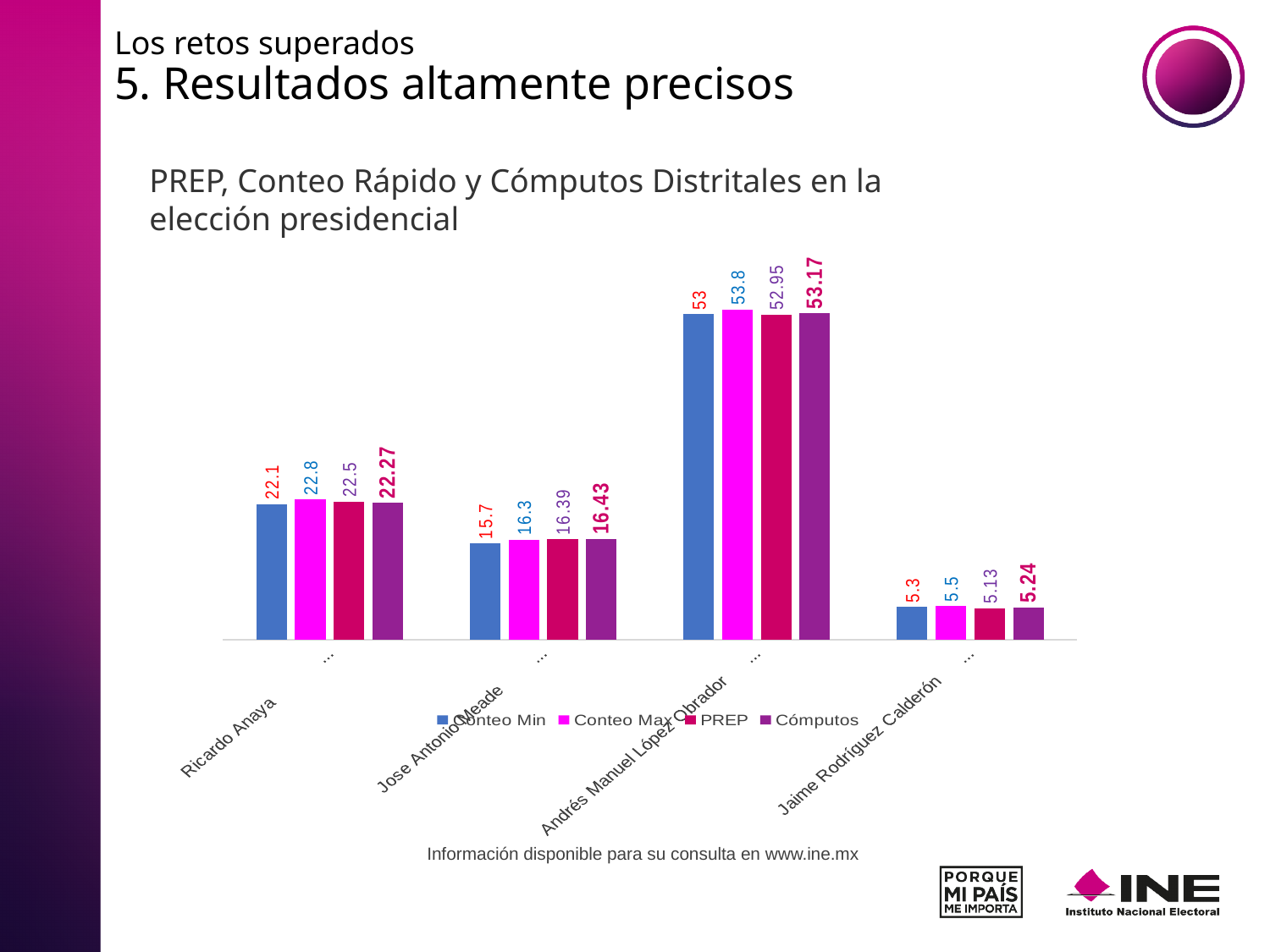
What is the difference between the Conteo Max and Conteo Min values for Andrés Manuel López Obrador? 0.8 Which candidate has the lowest PREP value? Jaime Rodríguez Calderón Which candidate has the highest Cómputos value? Andrés Manuel López Obrador What is the Conteo Min value for Jose Antonio Meade? 15.7 What is the PREP value for Ricardo Anaya? 22.5 What is the difference between the Cómputos values for Ricardo Anaya and Jose Antonio Meade? 5.84 What is the Conteo Max value for Jaime Rodríguez Calderón? 5.5 What is the Cómputos value for Andrés Manuel López Obrador? 53.17 What kind of chart is shown on the slide? Bar chart How many series does the legend list? 4 How many candidates are shown on the x axis of the chart? 4 Which is larger for Jose Antonio Meade, the PREP value or the Cómputos value? Cómputos